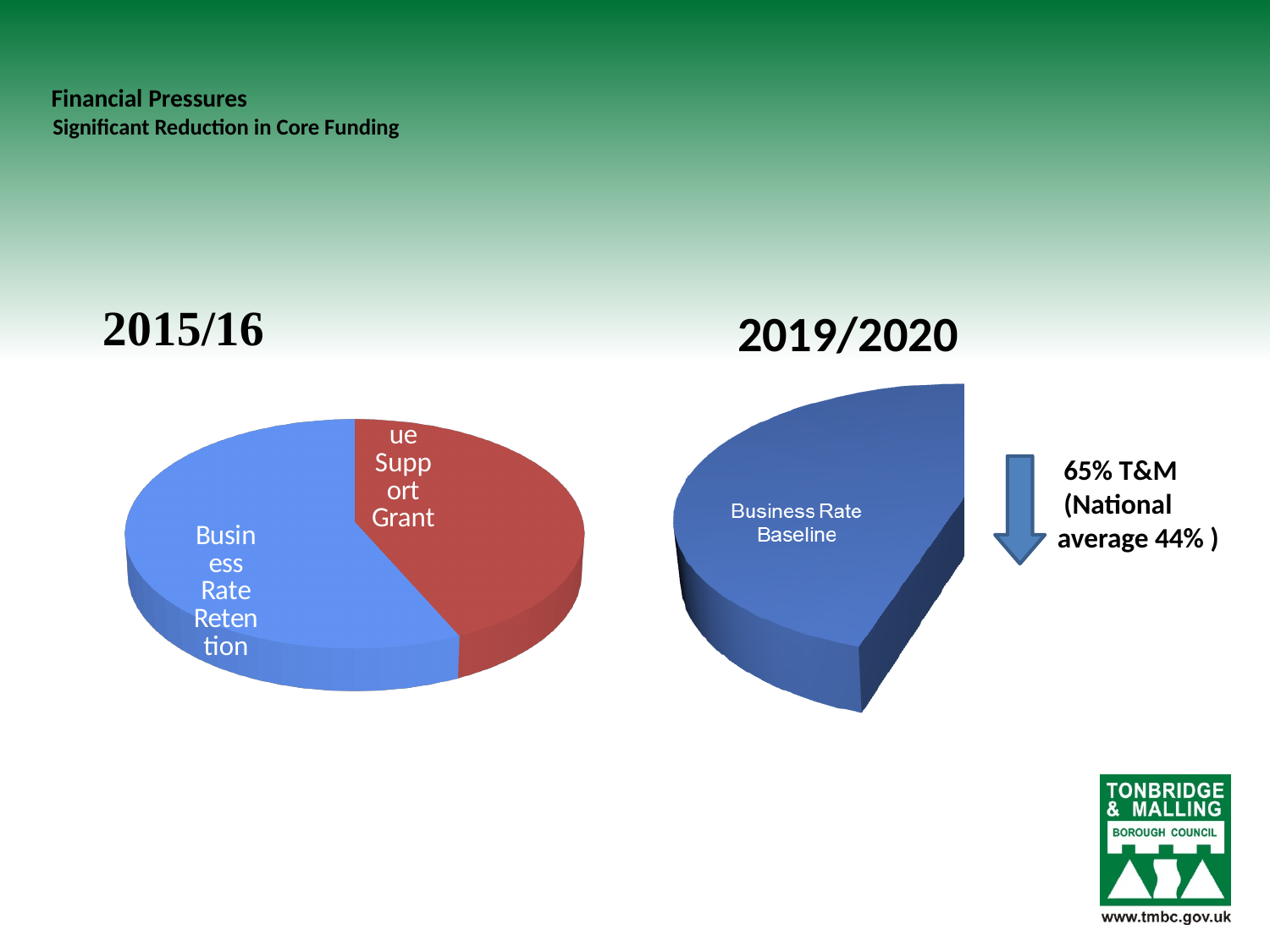
What kind of chart is the 2015/16 chart on the left? Pie chart In the 2019/2020 pie chart, what is the label of the slice shown? Business Rate Baseline In the 2015/16 pie chart, which slice is the largest? Business Rate Retention In the 2015/16 pie chart, is the Business Rate Retention slice greater or less than 50% of the pie? greater In the 2015/16 pie chart, what colour is the Business Rate Retention slice? Blue What kind of chart is the 2019/2020 chart on the right? Pie chart In the 2015/16 pie chart, which slice is larger: Business Rate Retention or the red slice? Business Rate Retention In the 2015/16 pie chart, how many slices are shown? 2 In the 2019/2020 pie chart, how many labelled slices are shown? 1